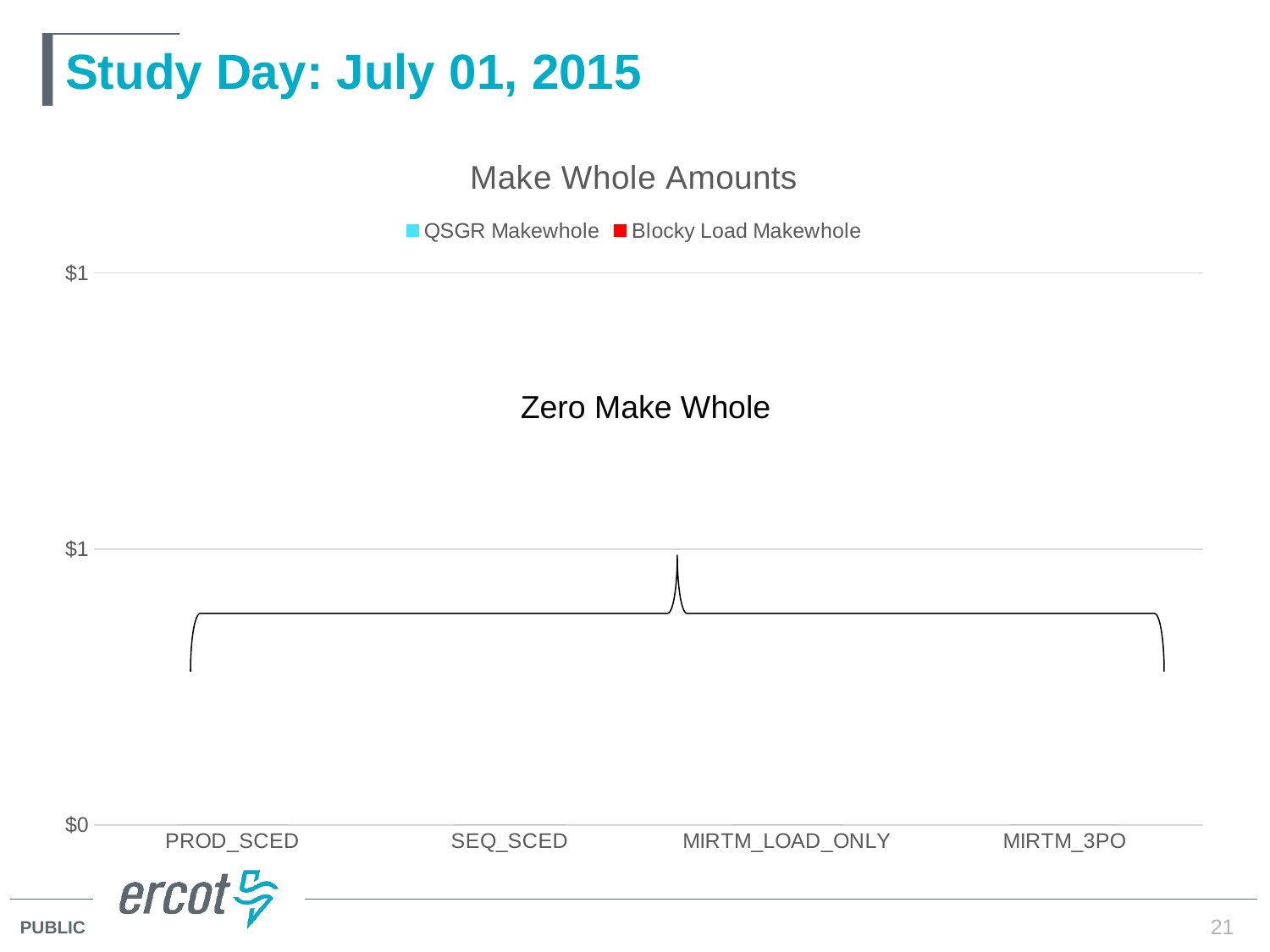
How many series does the chart legend list? 2 Which category is listed last on the x axis of the chart? MIRTM_3PO How many categories are shown on the x axis of the chart? 4 Which category is listed first on the x axis of the chart? PROD_SCED What is the lowest value label shown on the y axis of the chart? $0 According to the annotation on the chart, what is the make whole amount for every category? Zero